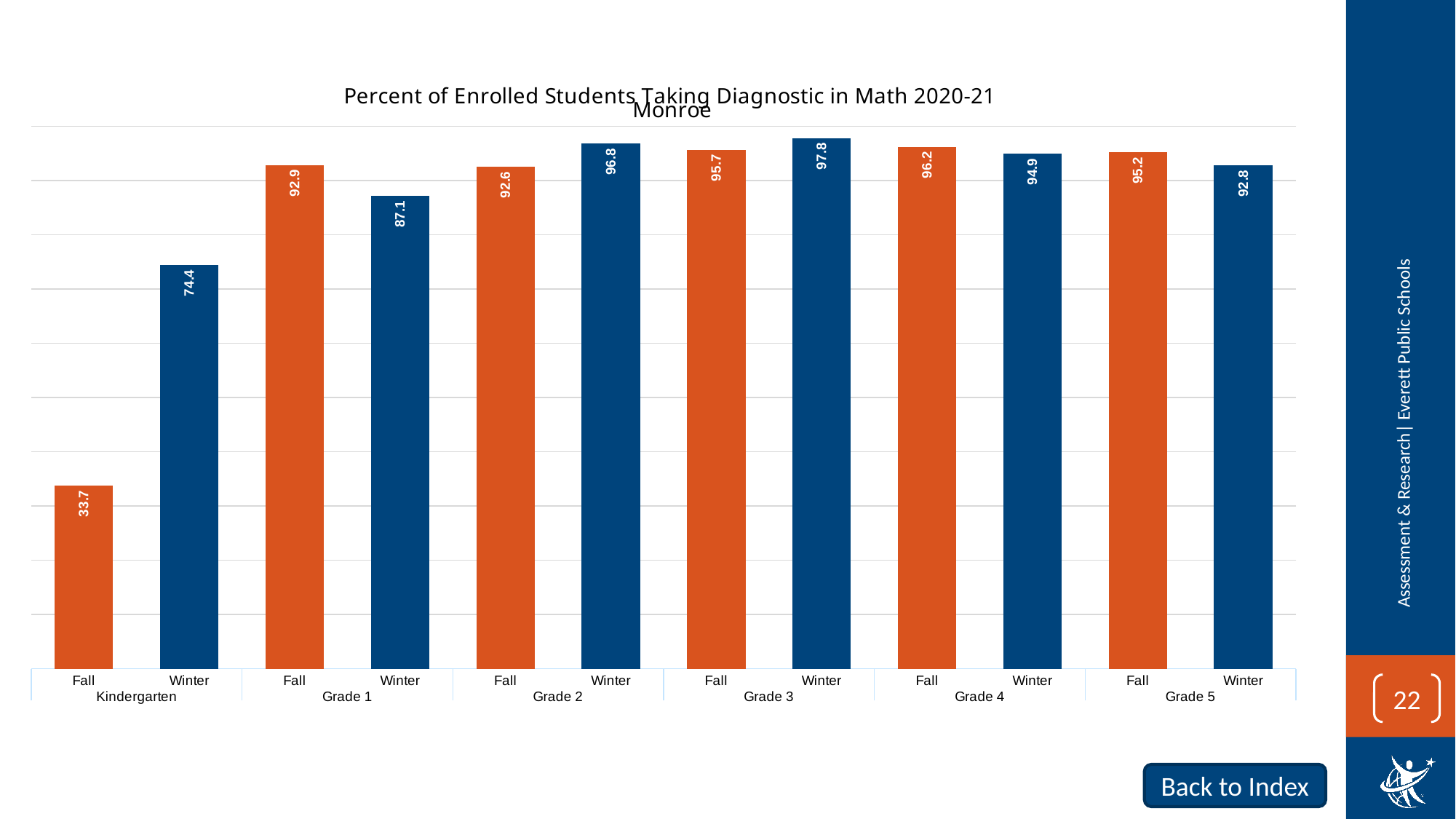
Which bar has the lowest value? Kindergarten Fall What is the value for Fall in Grade 5? 95.2 What is the value for Winter in Grade 1? 87.1 What is the title of the chart? Percent of Enrolled Students Taking Diagnostic in Math 2020-21 Monroe What is the difference between the Winter and Fall values for Kindergarten? 40.7 What is the value for Fall in Kindergarten? 33.7 Which is larger, the Fall value for Grade 4 or the Winter value for Grade 4? Fall Which bar has the highest value? Grade 3 Winter What is the value for Winter in Grade 3? 97.8 What is the difference between the Fall and Winter values for Grade 1? 5.8 What kind of chart is this? Bar chart How many grade levels are shown on the x axis? 6